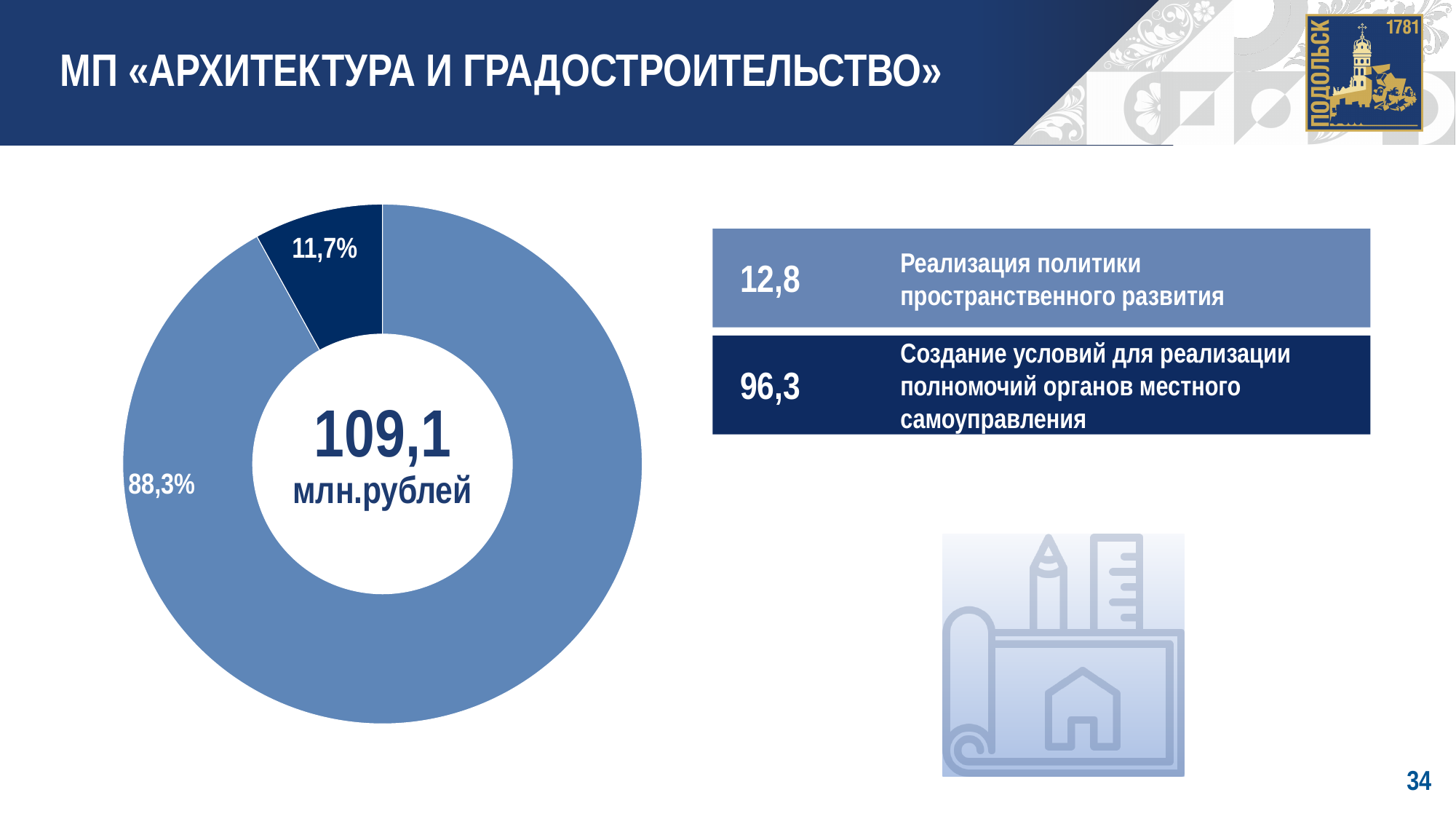
What is the difference between the values 96,3 and 12,8 shown next to the chart? 83,5 What percentage is printed on the smallest slice of the donut chart? 11,7% What value is shown for «Реализация политики пространственного развития»? 12,8 What kind of chart is shown on the slide? Donut (pie) chart What value is shown for «Создание условий для реализации полномочий органов местного самоуправления»? 96,3 What percentage is printed on the largest slice of the donut chart? 88,3% How many category labels are listed in the boxes to the right of the donut chart? 2 Which has the larger value: «Реализация политики пространственного развития» or «Создание условий для реализации полномочий органов местного самоуправления»? Создание условий для реализации полномочий органов местного самоуправления What is the sum of the two percentages printed on the donut chart slices? 100% How many slices does the donut chart have? 2 What is the title of the slide containing the donut chart? МП «АРХИТЕКТУРА И ГРАДОСТРОИТЕЛЬСТВО» What total value is printed in the centre of the donut chart? 109,1 млн.рублей